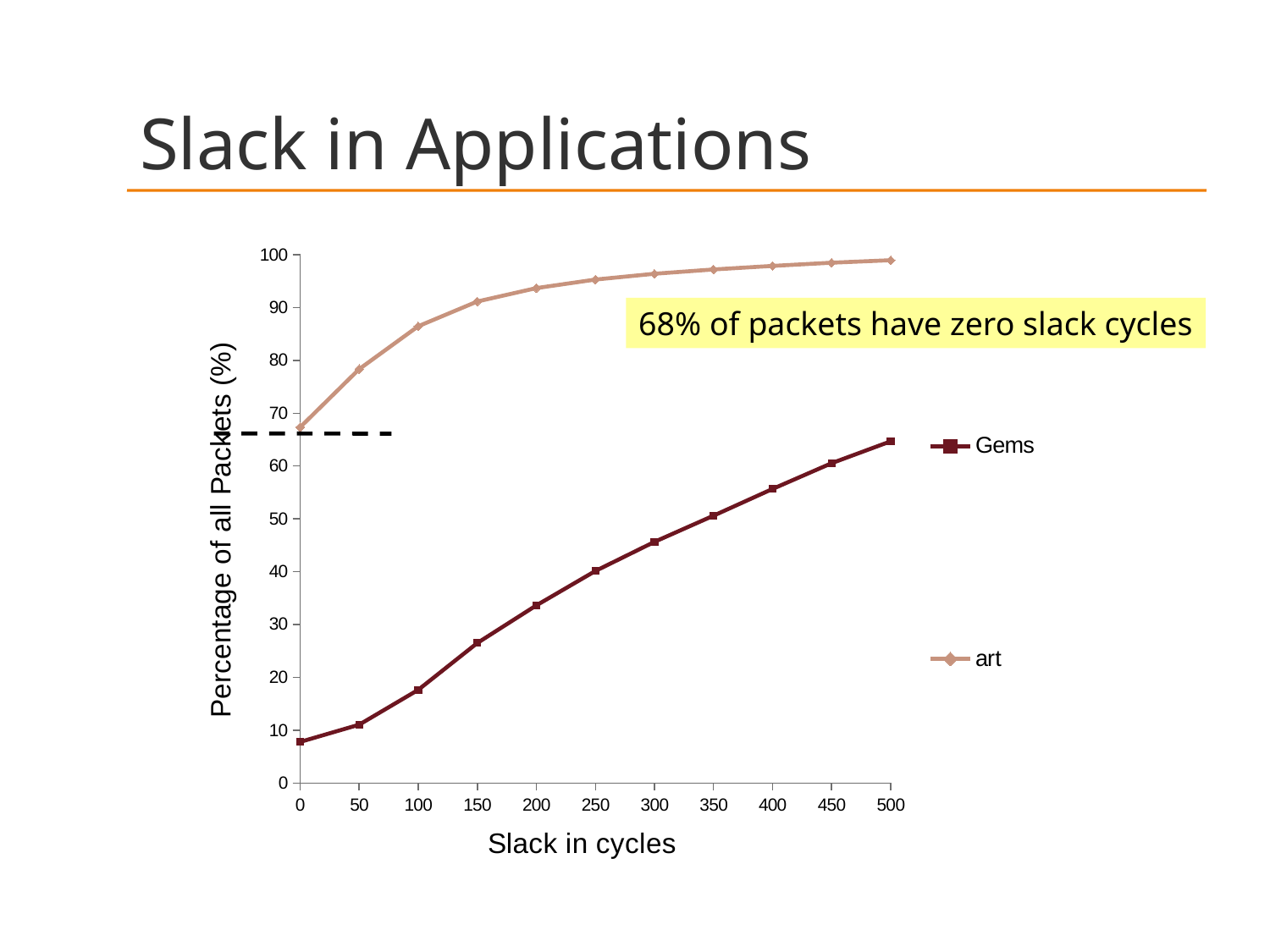
How many slack values (x-axis points) are plotted for each series? 11 What are the two series named in the legend? Gems and art Does the Gems series rise or fall as slack in cycles increases? rises How many series does the legend list? 2 Is the value for art at a slack of 0 cycles greater or less than 60? greater What kind of chart is shown on the slide? line chart At which slack value does the Gems series reach its highest percentage? 500 Is the value for Gems at a slack of 500 cycles greater or less than 60? greater What is the title of the x axis? Slack in cycles At a slack of 500 cycles, which series has the higher percentage of packets, Gems or art? art Is the value for Gems at a slack of 0 cycles greater or less than 10? less